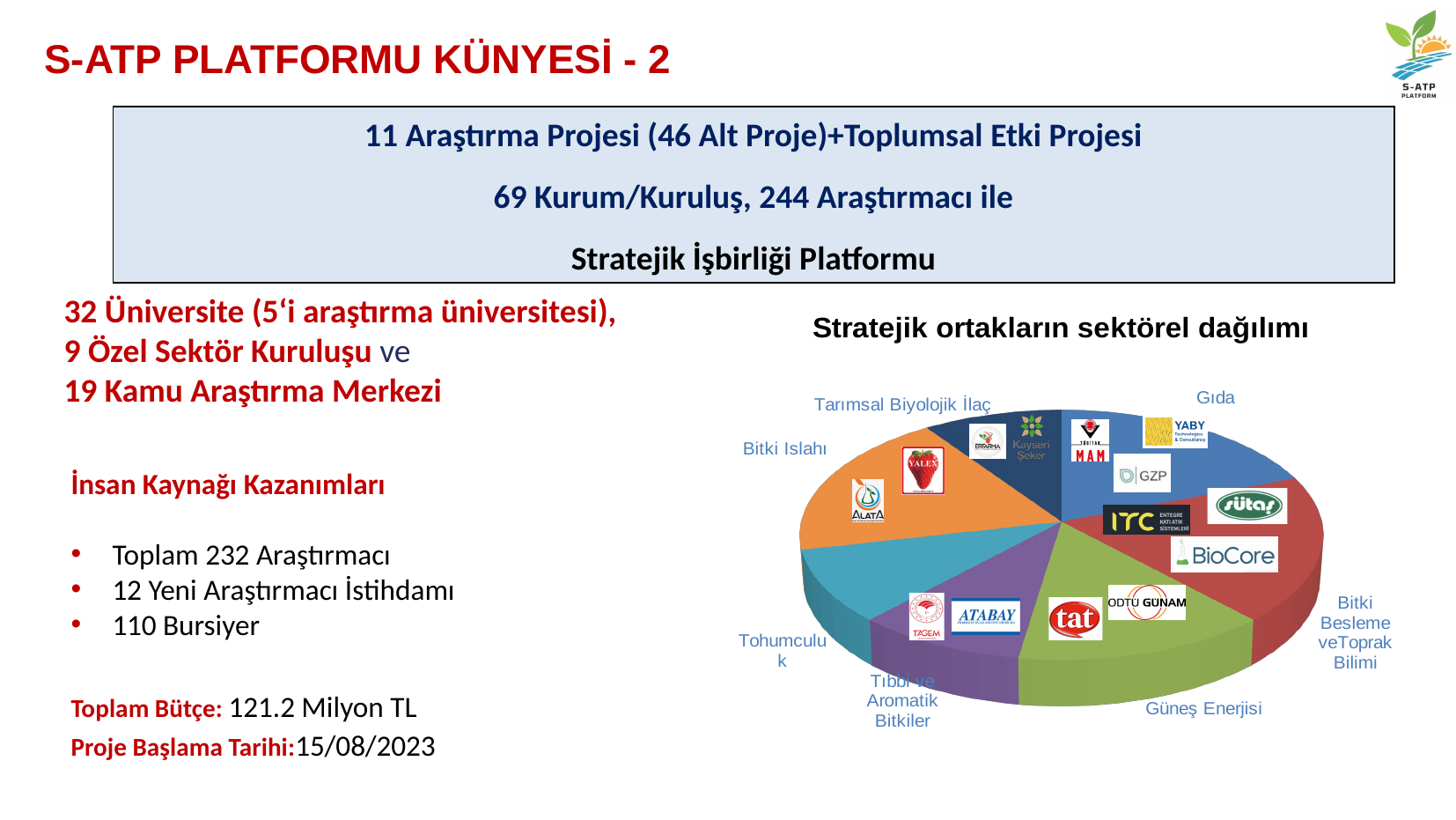
What kind of chart is shown under the title "Stratejik ortakların sektörel dağılımı"? pie chart What colour is the Gıda slice in the pie chart? blue In the pie chart, which slice is larger: Bitki Besleme ve Toprak Bilimi or Tıbbi ve Aromatik Bitkiler? Bitki Besleme ve Toprak Bilimi In the pie chart, which slice is larger: Gıda or Tohumculuk? Gıda What is the title of the pie chart on the slide? Stratejik ortakların sektörel dağılımı How many sector categories are labelled on the pie chart? 7